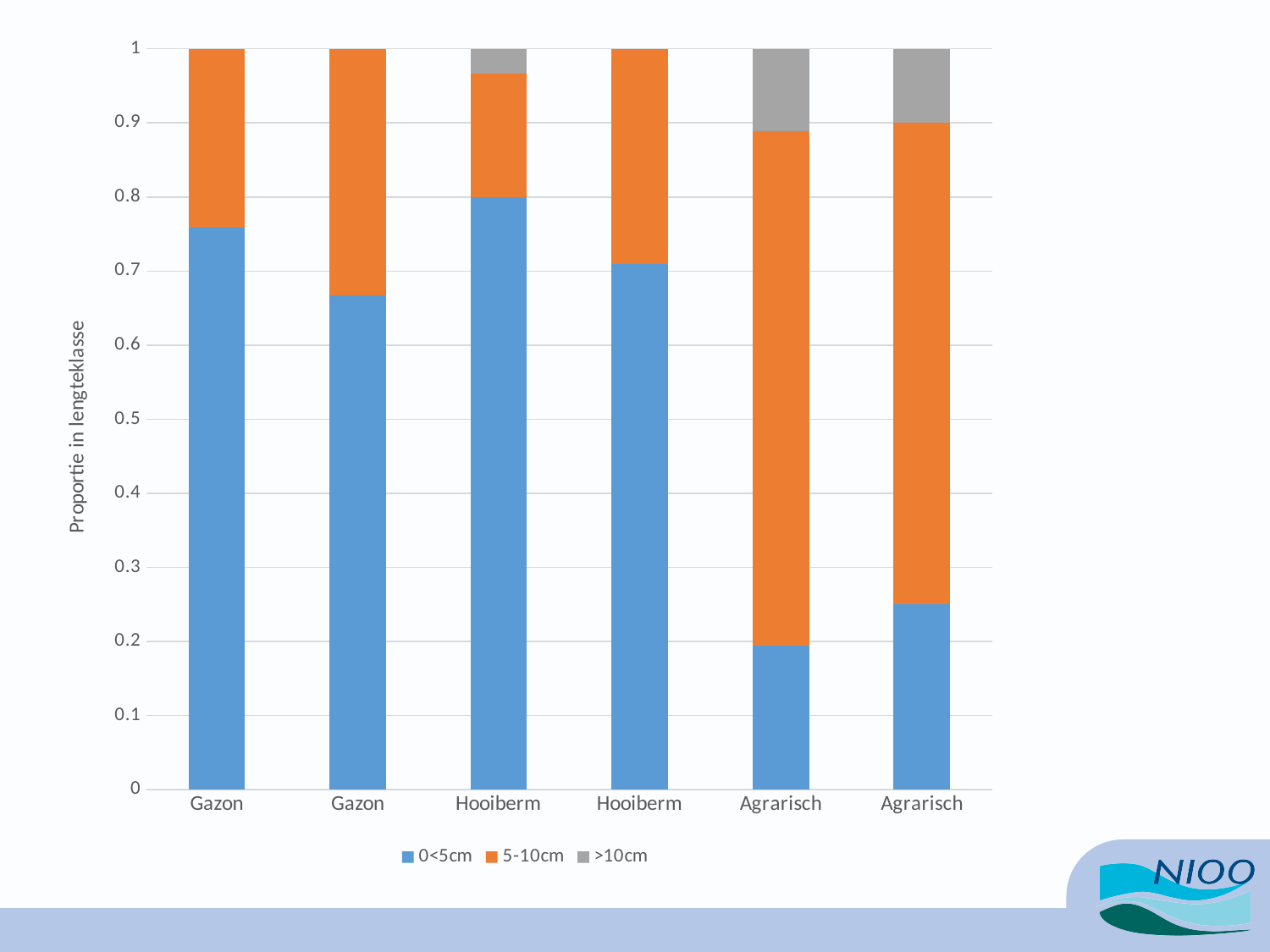
Which has the larger 0<5cm segment, the first Gazon bar or the second Gazon bar? the first Gazon bar Which bar has the smallest 0<5cm segment? the first Agrarisch bar What kind of chart is shown on the slide? stacked bar chart What is the total height of each stacked bar? 1 How many series does the legend list? 3 Is the 0<5cm value for the second Hooiberm bar greater or less than 0.8? less Which bar has the largest 0<5cm segment? the first Hooiberm bar Is the 0<5cm value for the first Gazon bar greater or less than 0.7? greater Is the 0<5cm value for the second Agrarisch bar greater or less than 0.3? less How many bars are plotted in the chart? 6 Which series is shown in grey in the legend? >10cm What is the title of the vertical axis? Proportie in lengteklasse